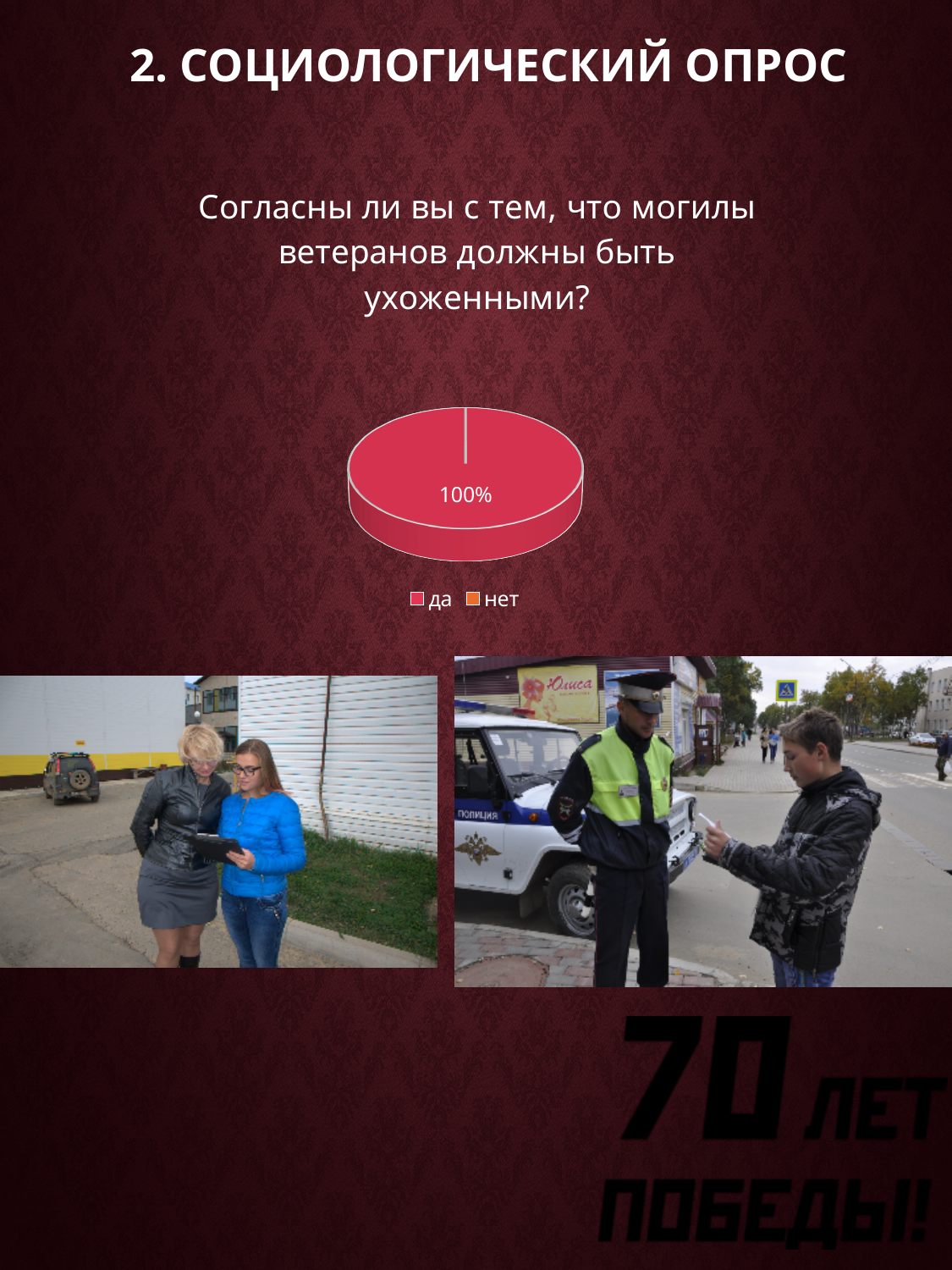
What value is printed on the pie chart? 100% What share of the pie does the "да" slice take? 100% What colour is the "да" slice in the pie chart? red What kind of chart is shown on the slide? pie chart Which category has the largest share of the pie? да How many entries does the legend of the pie chart list? 2 Which of the two categories, "да" or "нет", has the larger share? да How many slices are visible in the pie chart? 1 What question is the pie chart answering, according to the text above it? Согласны ли вы с тем, что могилы ветеранов должны быть ухоженными?